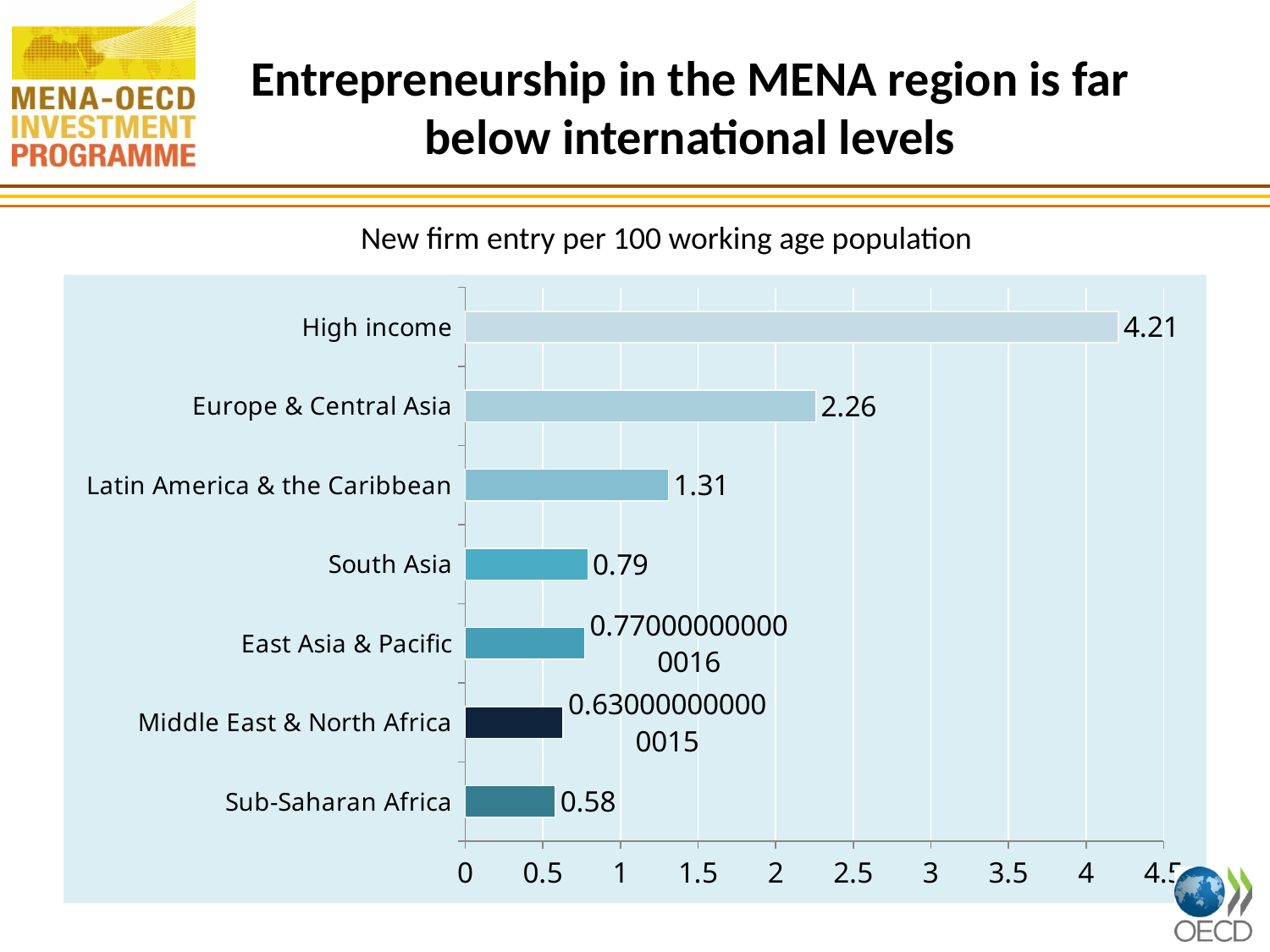
What is the value for Europe & Central Asia? 2.26 What is the difference between the values for High income and Europe & Central Asia? 1.95 Which region has the highest new firm entry rate? High income Which is larger, the value for Latin America & the Caribbean or the value for South Asia? Latin America & the Caribbean What is the value for Sub-Saharan Africa? 0.58 What is the value for High income? 4.21 What is the value for Latin America & the Caribbean? 1.31 Is the value for Middle East & North Africa greater or less than 1? less Which region has the lowest new firm entry rate? Sub-Saharan Africa What is the title of the chart? New firm entry per 100 working age population What kind of chart is shown on the slide? bar chart How many regions are shown in the chart? 7